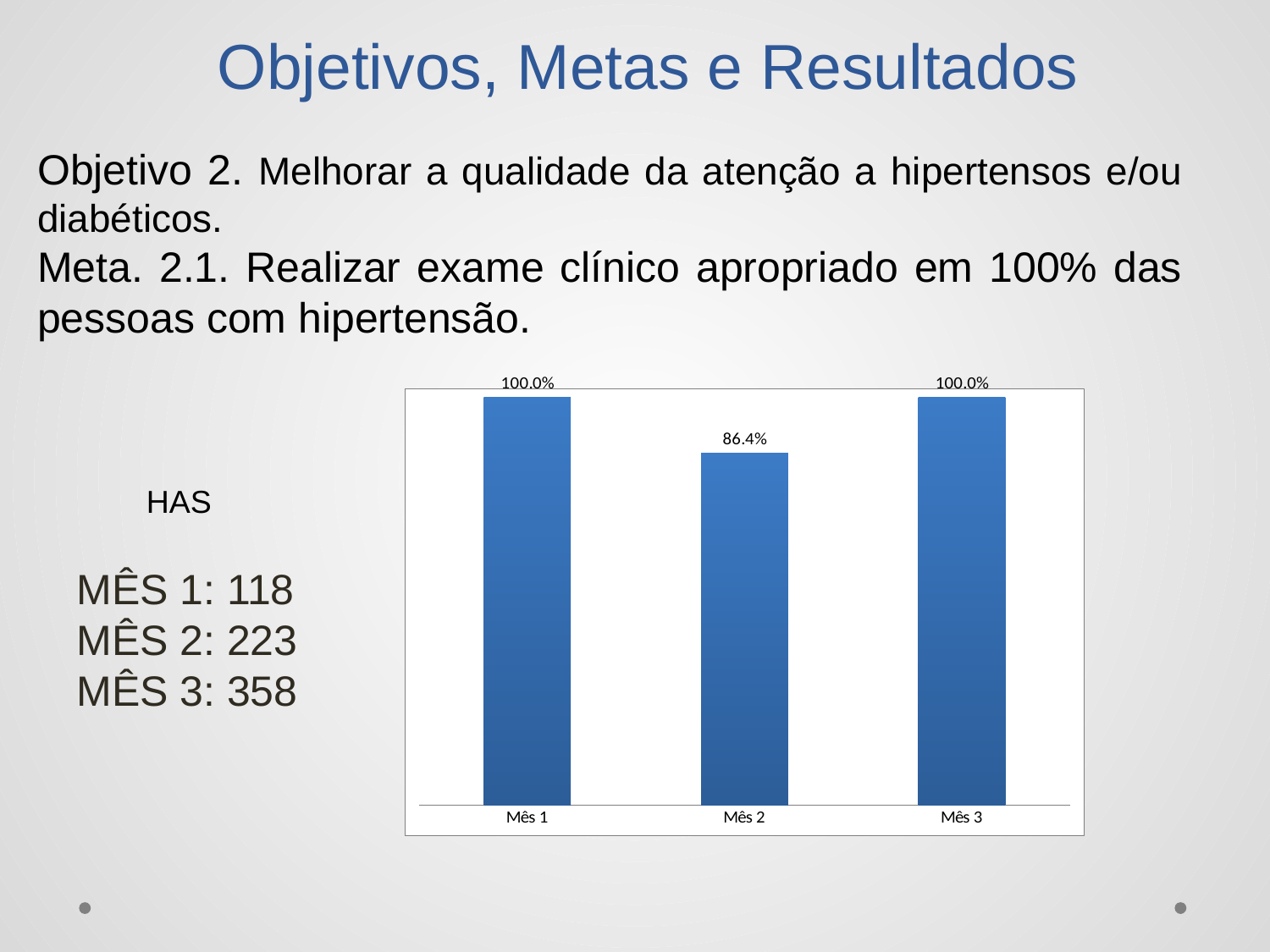
What is the value shown for Mês 2? 86.4% What colour are the bars in the chart? Blue How many categories are plotted in the chart? 3 What is the difference between the values for Mês 3 and Mês 2? 13.6% What is the difference between the values for Mês 1 and Mês 2? 13.6% What is the value shown for Mês 3? 100.0% Which is larger, the value for Mês 2 or the value for Mês 3? Mês 3 Which is larger, the value for Mês 1 or the value for Mês 2? Mês 1 Do the values rise or fall from Mês 1 to Mês 2? Fall What kind of chart is shown on the slide? Bar chart Which month has the lowest value in the chart? Mês 2 What is the value shown for Mês 1? 100.0%